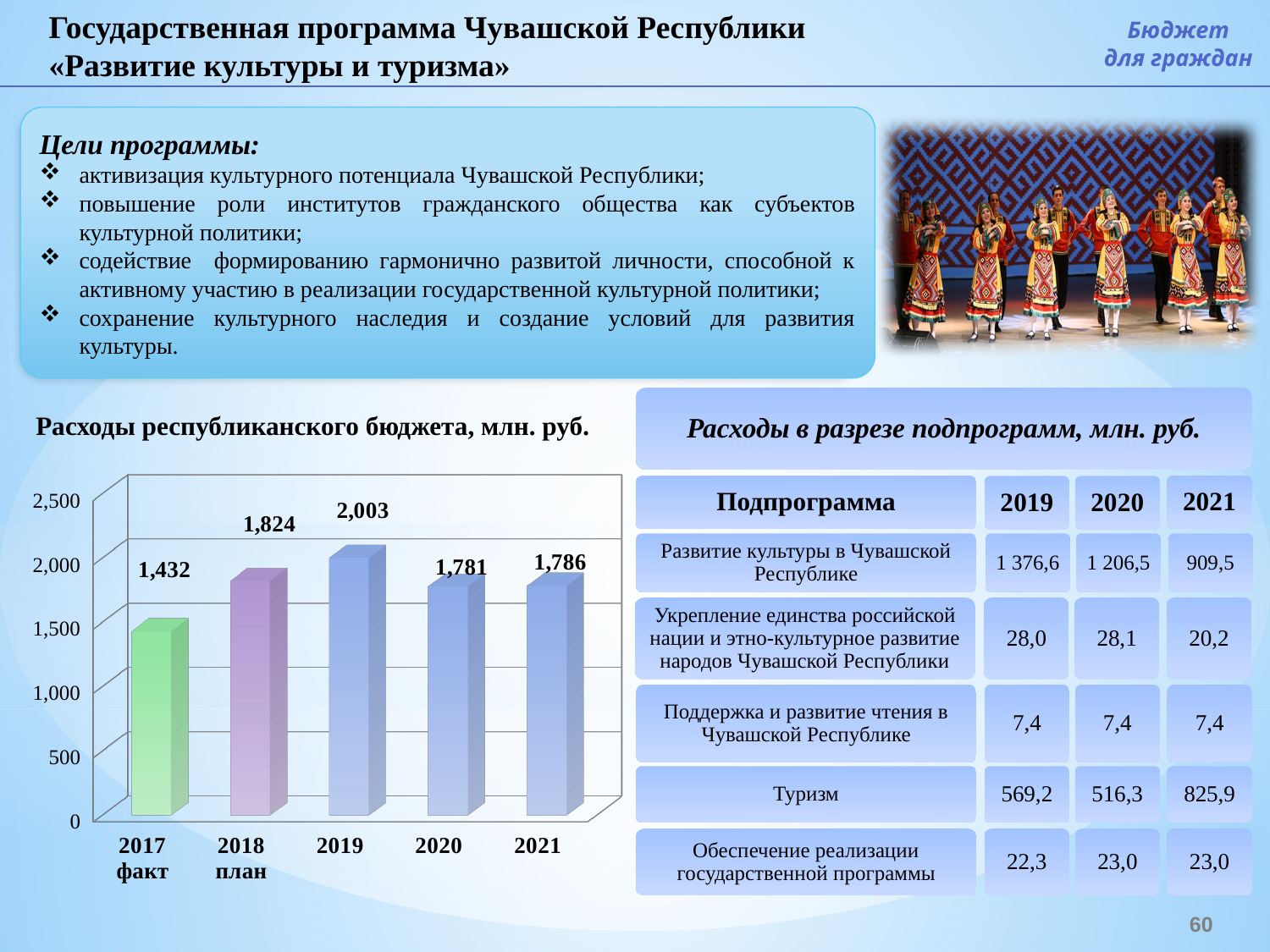
In the chart 'Расходы республиканского бюджета, млн. руб.', what is the difference between the values for 2018 план and 2017 факт? 392 In the chart 'Расходы республиканского бюджета, млн. руб.', do the values rise or fall from 2017 факт to 2019? rise What kind of chart is 'Расходы республиканского бюджета, млн. руб.'? bar chart How many bars are shown in the chart 'Расходы республиканского бюджета, млн. руб.'? 5 In the chart 'Расходы республиканского бюджета, млн. руб.', what is the value for 2019? 2,003 In the chart 'Расходы республиканского бюджета, млн. руб.', what is the value for 2017 факт? 1,432 In the chart 'Расходы республиканского бюджета, млн. руб.', what is the difference between the values for 2019 and 2017 факт? 571 In the chart 'Расходы республиканского бюджета, млн. руб.', which is larger, the value for 2018 план or the value for 2020? 2018 план In the chart 'Расходы республиканского бюджета, млн. руб.', what is the value for 2020? 1,781 In the chart 'Расходы республиканского бюджета, млн. руб.', which year has the highest value? 2019 In the chart 'Расходы республиканского бюджета, млн. руб.', is the value for 2017 факт greater or less than 1,500? less In the chart 'Расходы республиканского бюджета, млн. руб.', which year has the lowest value? 2017 факт